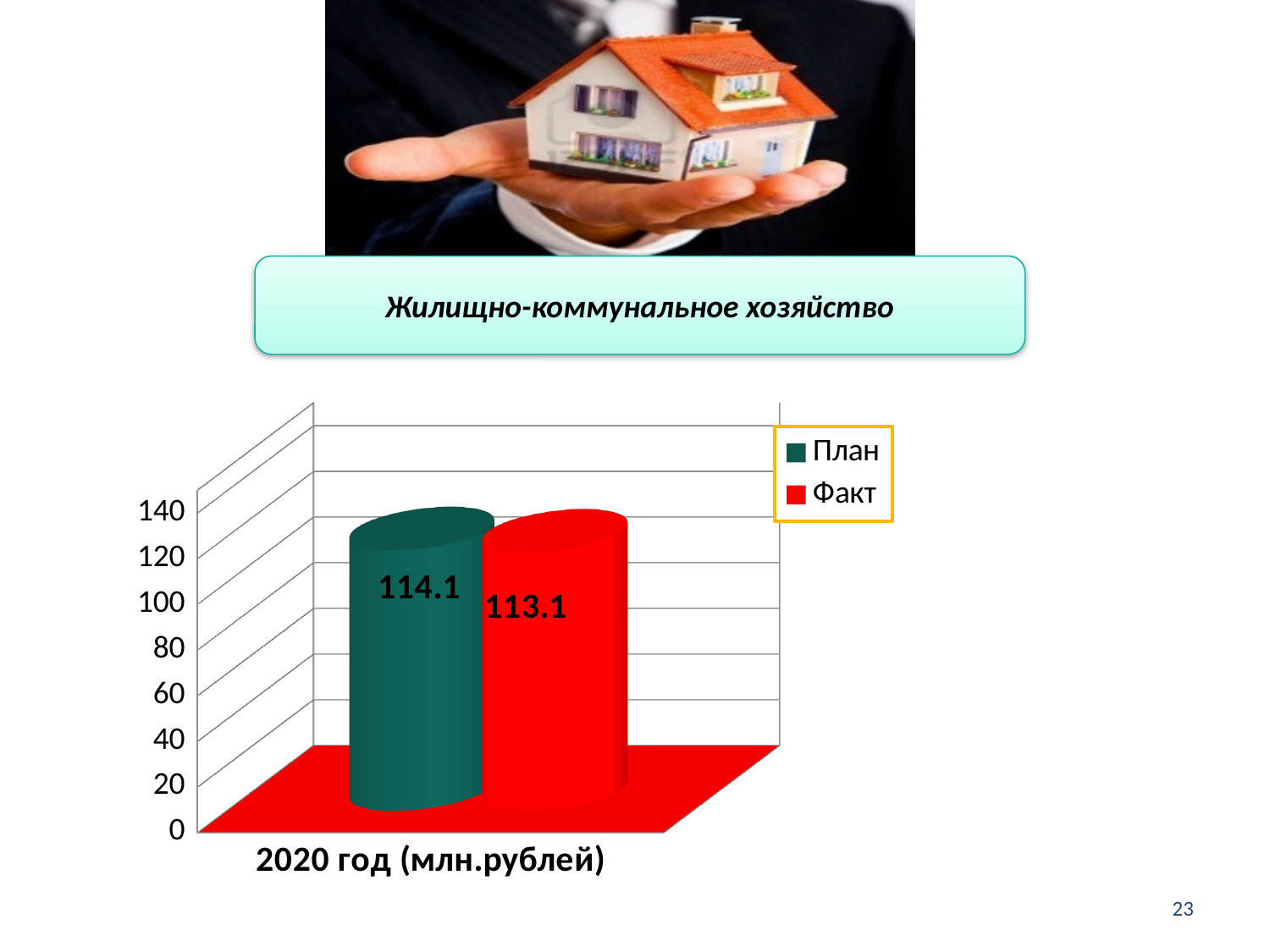
Is the value for Факт greater or less than 100? greater What kind of chart is shown on the slide? bar chart Which series has the higher value, План or Факт? План How many series does the legend list? 2 What is the difference between the План and Факт values? 1.0 What is the label on the x axis of the chart? 2020 год (млн.рублей) What colour is the Факт series in the chart? red What is the highest tick value shown on the vertical axis? 140 Is the value for План greater or less than 120? less How many categories are shown on the x axis of the chart? 1 What is the value for Факт (actual) in the chart? 113.1 What is the value for План (plan) in the chart? 114.1